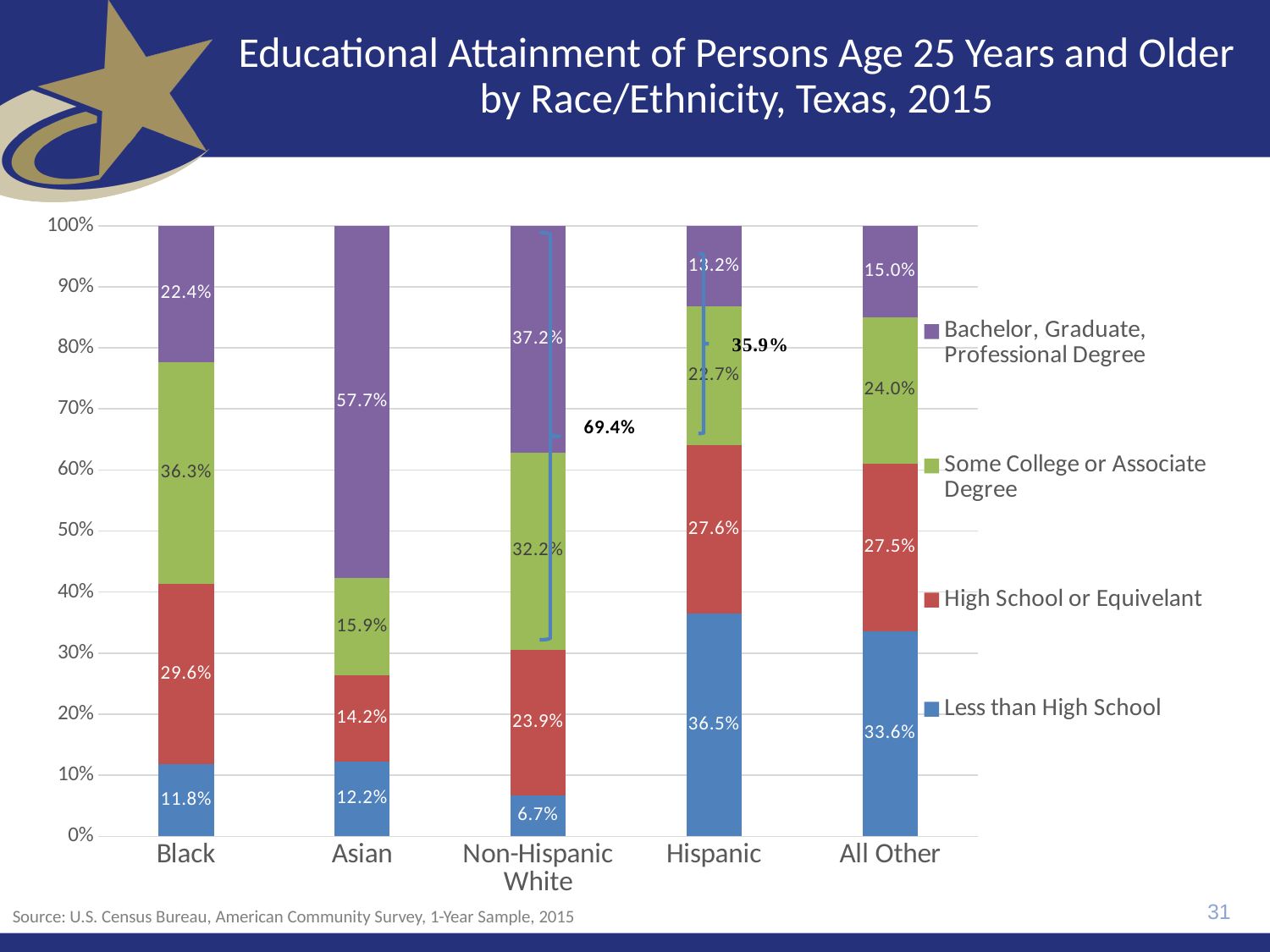
Which group has the larger High School or Equivelant share, Black or Asian? Black What percentage of Black persons age 25 and older have less than a high school education? 11.8% What is the difference in percentage points between the Bachelor, Graduate, Professional Degree share for Asian and for Black persons? 35.3 percentage points How many race/ethnicity categories are shown on the x axis? 5 How many series does the legend list? 4 Which group has the highest share with less than a high school education? Hispanic What kind of chart is shown on the slide? Stacked bar chart What is the Some College or Associate Degree share for the All Other group? 24.0% What combined percentage is annotated next to the Non-Hispanic White bar for Some College or Associate Degree plus Bachelor, Graduate, Professional Degree? 69.4% Is the Bachelor, Graduate, Professional Degree share for Asian persons greater or less than 50%? greater What is the Bachelor, Graduate, Professional Degree share for Asian persons? 57.7% Which group has the lowest share with less than a high school education? Non-Hispanic White